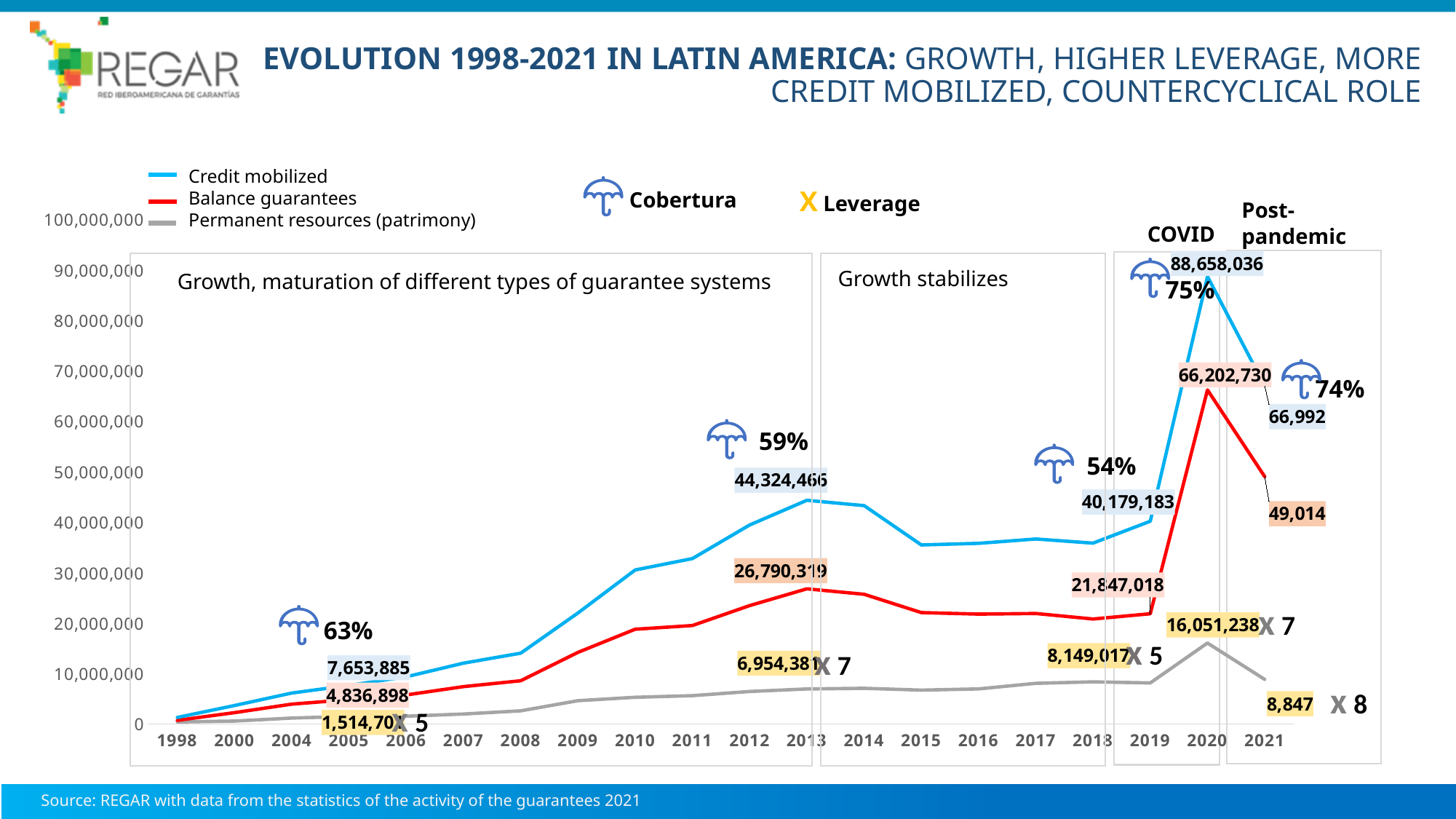
What is the value of Balance guarantees in 2013? 26,790,319 How many series does the legend list? 3 Is the value of Balance guarantees in 2015 greater or less than 30,000,000? less In which year is Credit mobilized at its highest? 2020 How many years are shown on the x axis? 20 What kind of chart is shown on the slide? line chart What is the difference between Credit mobilized and Balance guarantees in 2020? 22,455,306 Does Credit mobilized rise or fall from 2020 to 2021? fall What is the value of Credit mobilized in 2020? 88,658,036 What coverage (Cobertura) percentage is shown for 2020? 75% Which year has the larger Credit mobilized value, 2013 or 2018? 2013